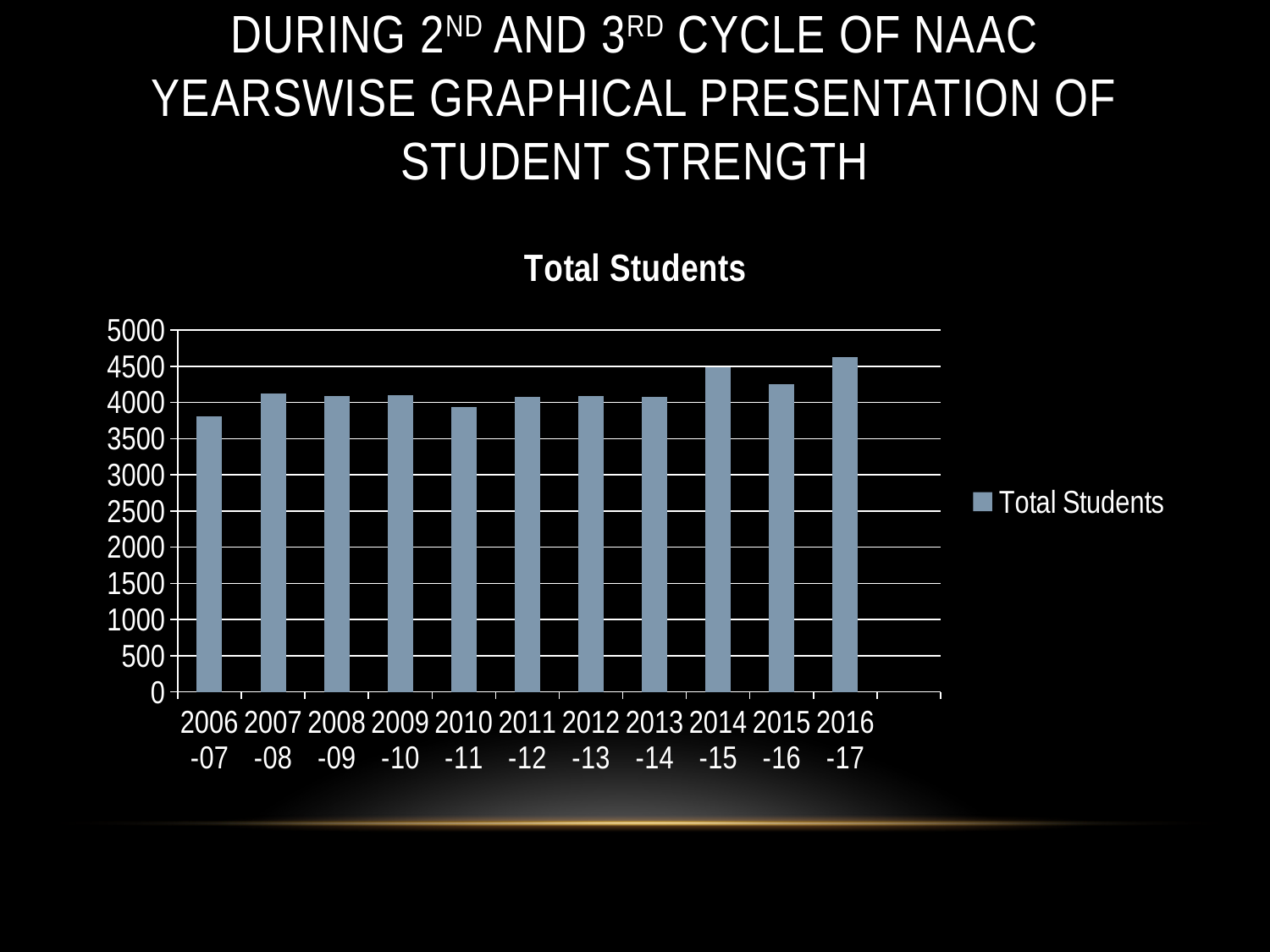
What is the title of the chart? Total Students What type of chart is shown on the slide? Bar chart Which year has more total students, 2006-07 or 2016-17? 2016-17 How many series does the legend list? 1 Is the value for 2006-07 greater or less than 4000? less Is the value for 2016-17 greater or less than 4500? greater Which year has more total students, 2014-15 or 2015-16? 2014-15 Which academic year has the lowest number of total students? 2006-07 Which academic year has the highest number of total students? 2016-17 How many academic years are shown on the x axis? 11 Is the value for 2015-16 greater or less than 4500? less